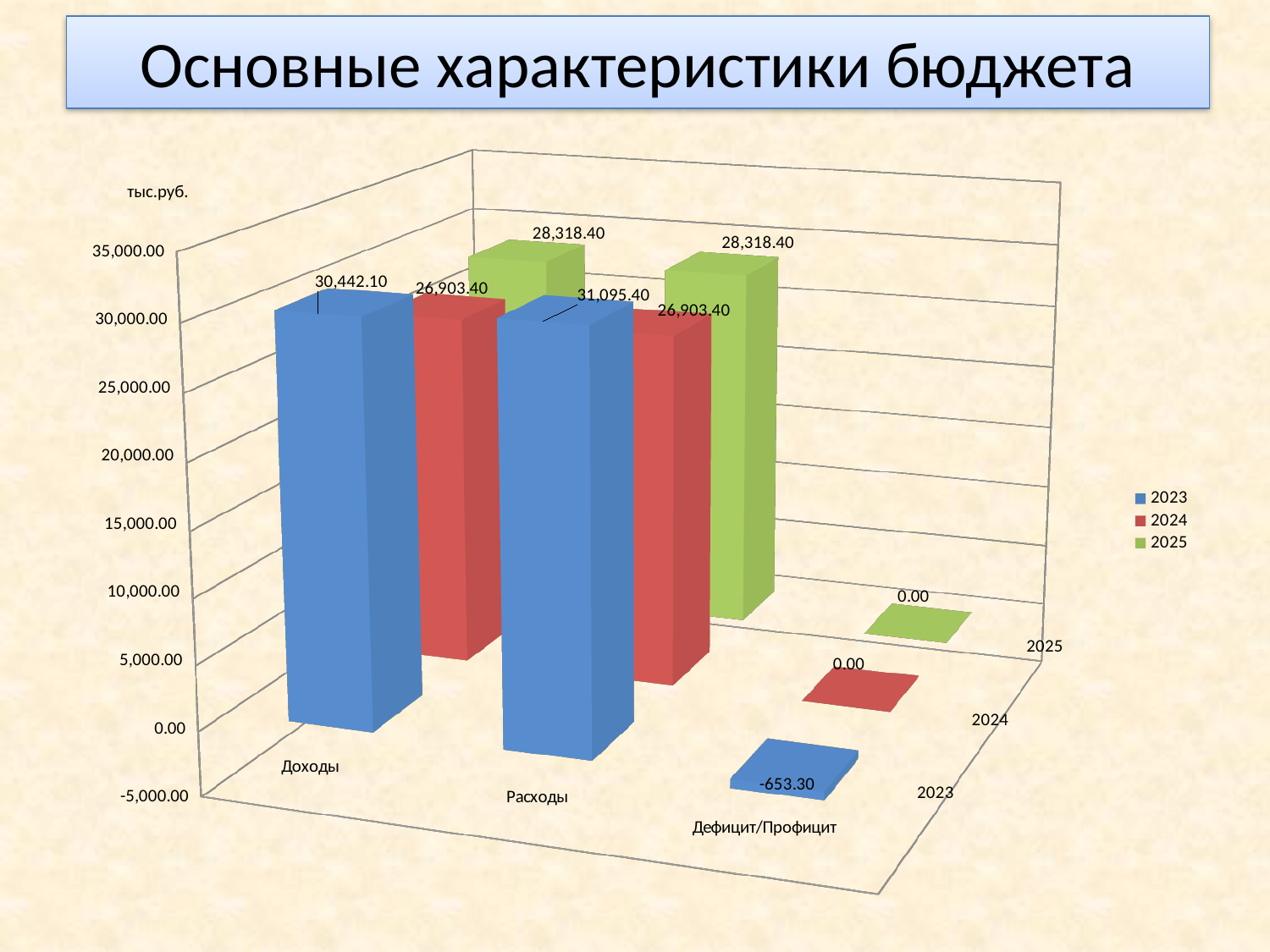
What is the value of Расходы for 2023? 31,095.40 Which year has the lowest value for Доходы? 2024 What is the value of Дефицит/Профицит for 2025? 0.00 How many series does the legend list? 3 What is the difference between Расходы and Доходы for 2023? 653.30 What is the value of Дефицит/Профицит for 2023? -653.30 What type of chart is shown on the slide? bar chart What is the value of Доходы for 2024? 26,903.40 What is the value of Расходы for 2025? 28,318.40 Which year has the highest value for Расходы? 2023 What is the value of Доходы for 2023? 30,442.10 How many categories are shown on the x axis? 3